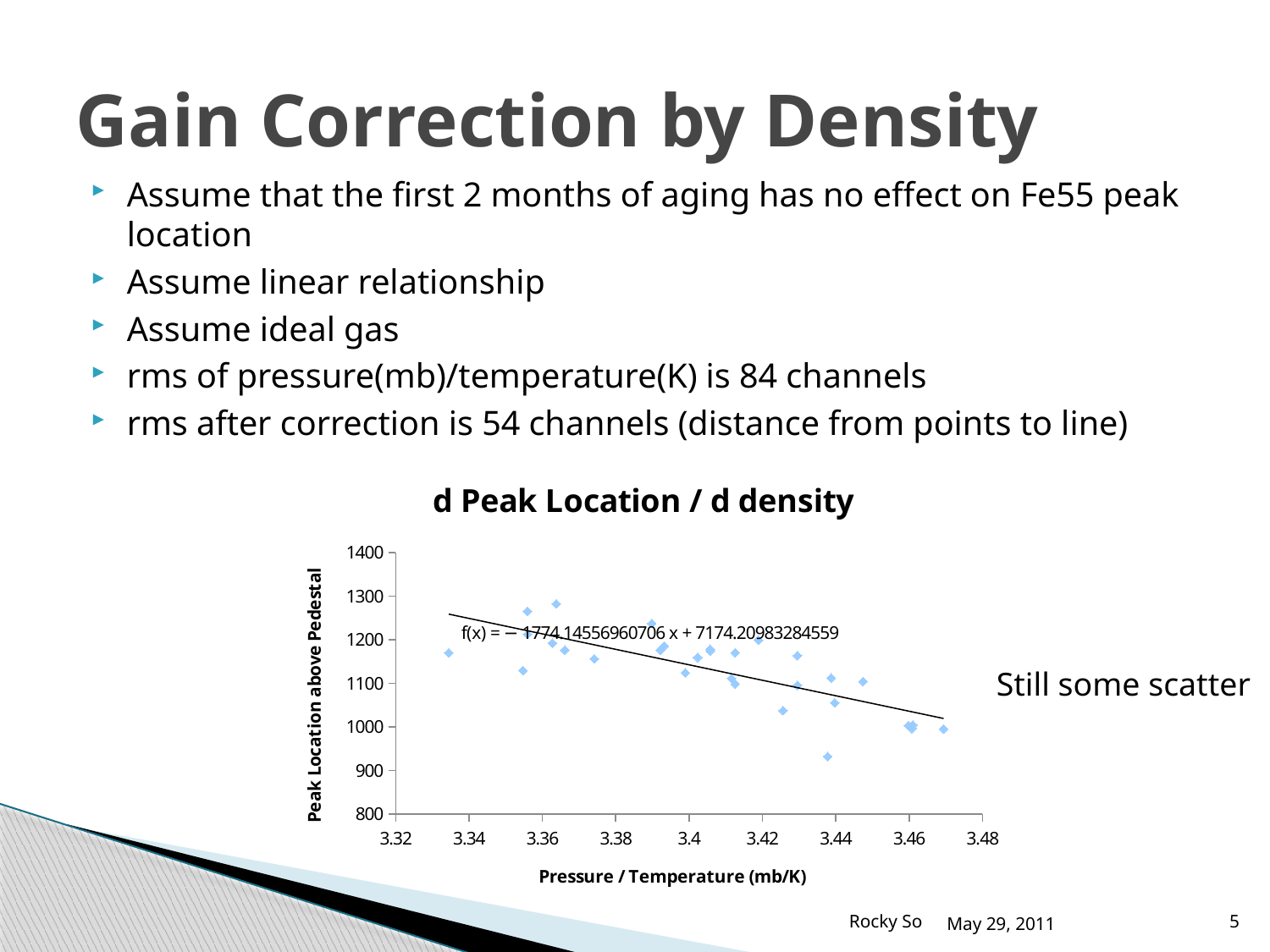
Is the highest plotted point on the chart greater or less than 1300? less Is the highest plotted point on the chart greater or less than 1200? greater Is the lowest plotted point on the chart greater or less than 900? greater Is the slope of the fitted line on the chart positive or negative? negative What kind of chart is shown on the slide? scatter chart What is the title of the chart? d Peak Location / d density What equation is printed for the fitted line on the chart? f(x) = − 1774.14556960706 x + 7174.20983284559 Do the plotted peak location values generally rise or fall as Pressure / Temperature increases along the x axis? fall